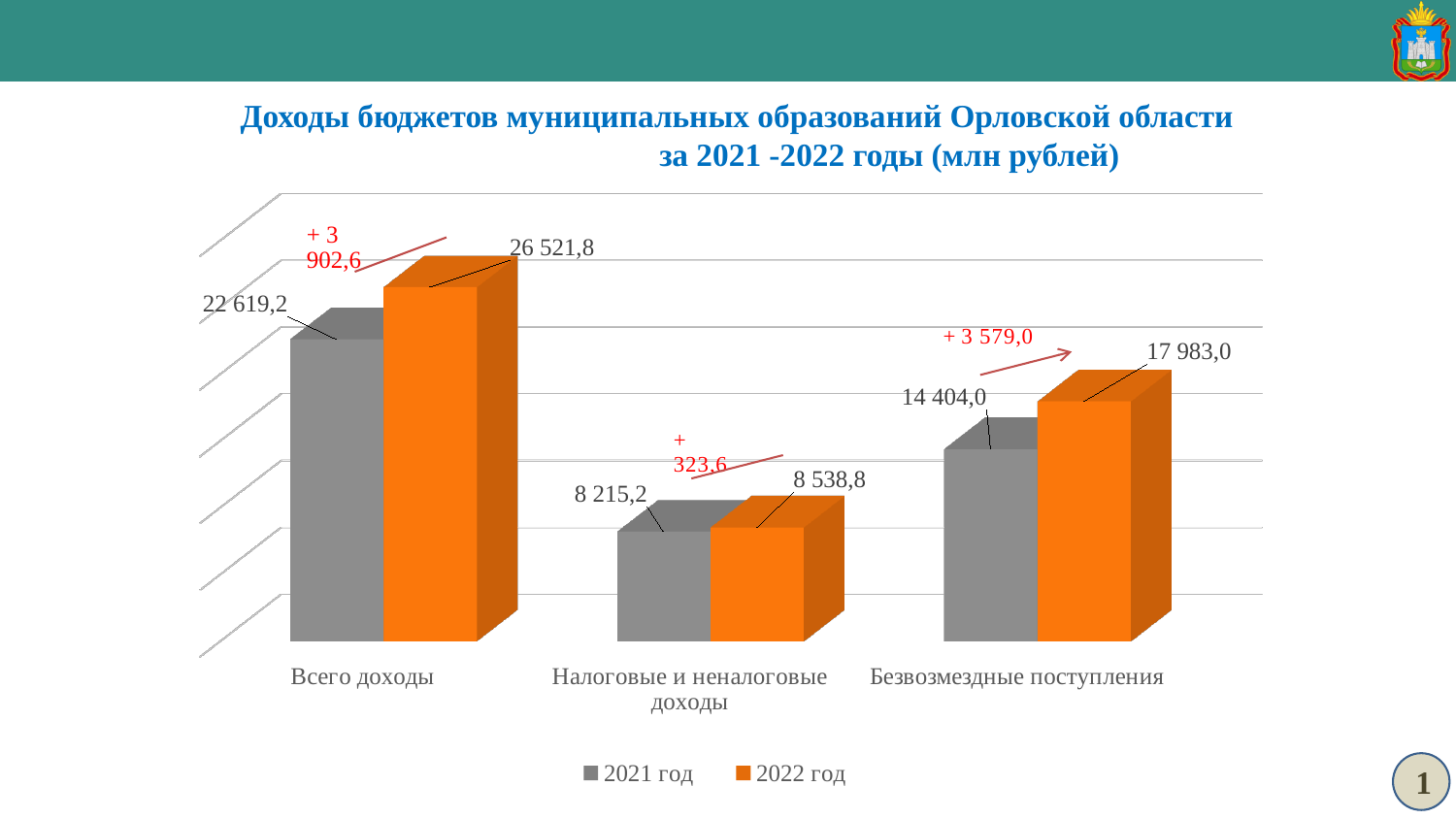
Which category has the lowest value in 2022 год? Налоговые и неналоговые доходы How many series does the legend list? 2 What is the value for Безвозмездные поступления in 2022 год? 17 983,0 Which is larger: the 2021 год value for Безвозмездные поступления or the 2022 год value for Налоговые и неналоговые доходы? 2021 год value for Безвозмездные поступления What is the value for Всего доходы in 2022 год? 26 521,8 What is the difference between the 2022 год and 2021 год values for Налоговые и неналоговые доходы? 323,6 How many categories are shown on the x axis? 3 What kind of chart is shown on the slide? Bar chart What is the value for Всего доходы in 2021 год? 22 619,2 Which category has the highest value in 2021 год? Всего доходы What is the difference between the 2022 год and 2021 год values for Безвозмездные поступления? 3 579,0 What is the value for Налоговые и неналоговые доходы in 2021 год? 8 215,2